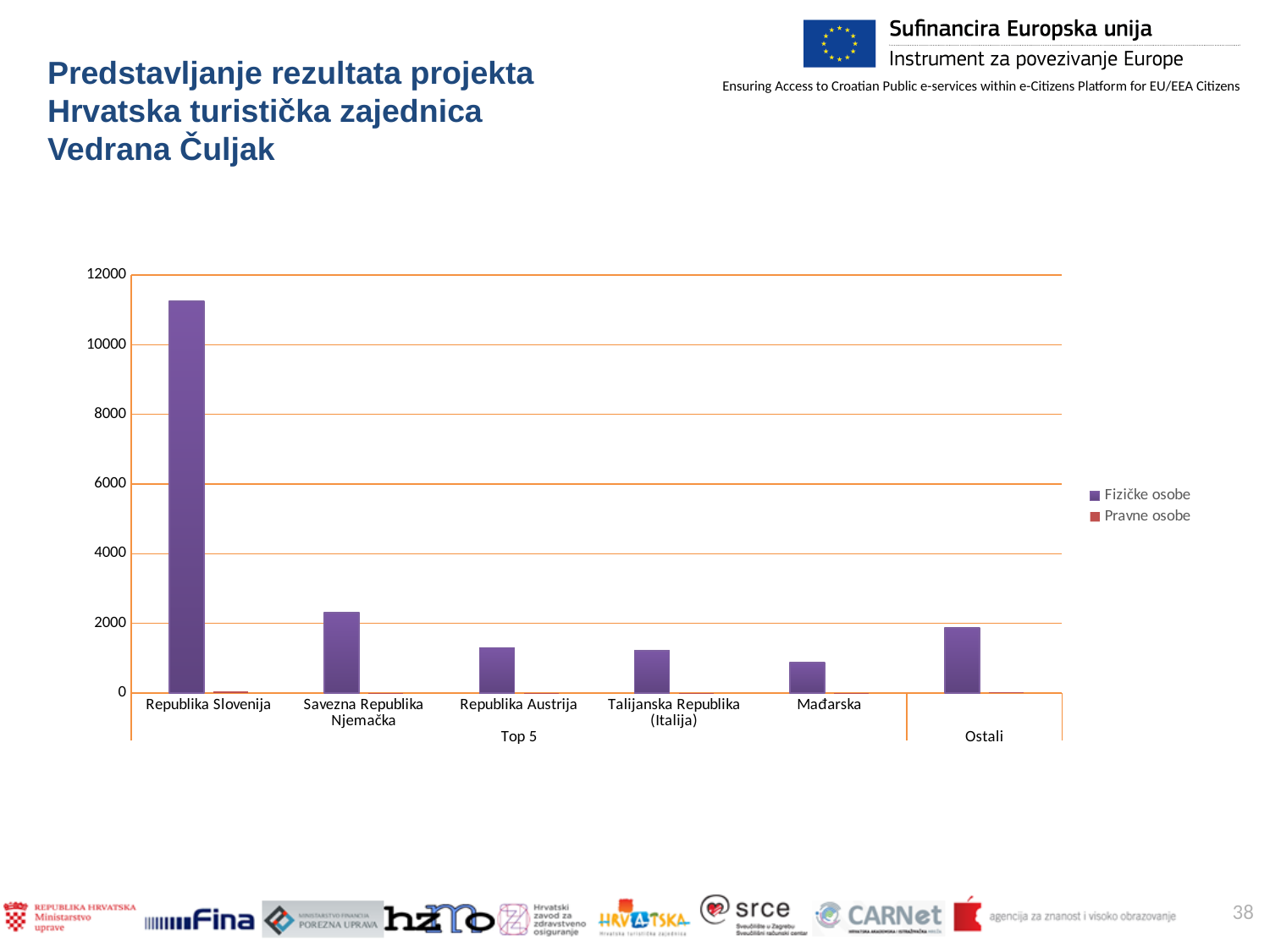
Is the Fizičke osobe value for Republika Austrija greater or less than 2000? less What are the two series named in the legend? Fizičke osobe and Pravne osobe Which category has the lowest value for Fizičke osobe? Mađarska Which has a larger Fizičke osobe value, Savezna Republika Njemačka or Republika Austrija? Savezna Republika Njemačka Which has a larger Fizičke osobe value, Ostali or Mađarska? Ostali Is the Fizičke osobe value for Republika Slovenija greater or less than 10000? greater How many series does the legend list? 2 What kind of chart is shown on the slide? bar chart Is the Fizičke osobe value for Savezna Republika Njemačka greater or less than 2000? greater How many categories are shown along the x axis? 6 Which category has the highest value for Fizičke osobe? Republika Slovenija